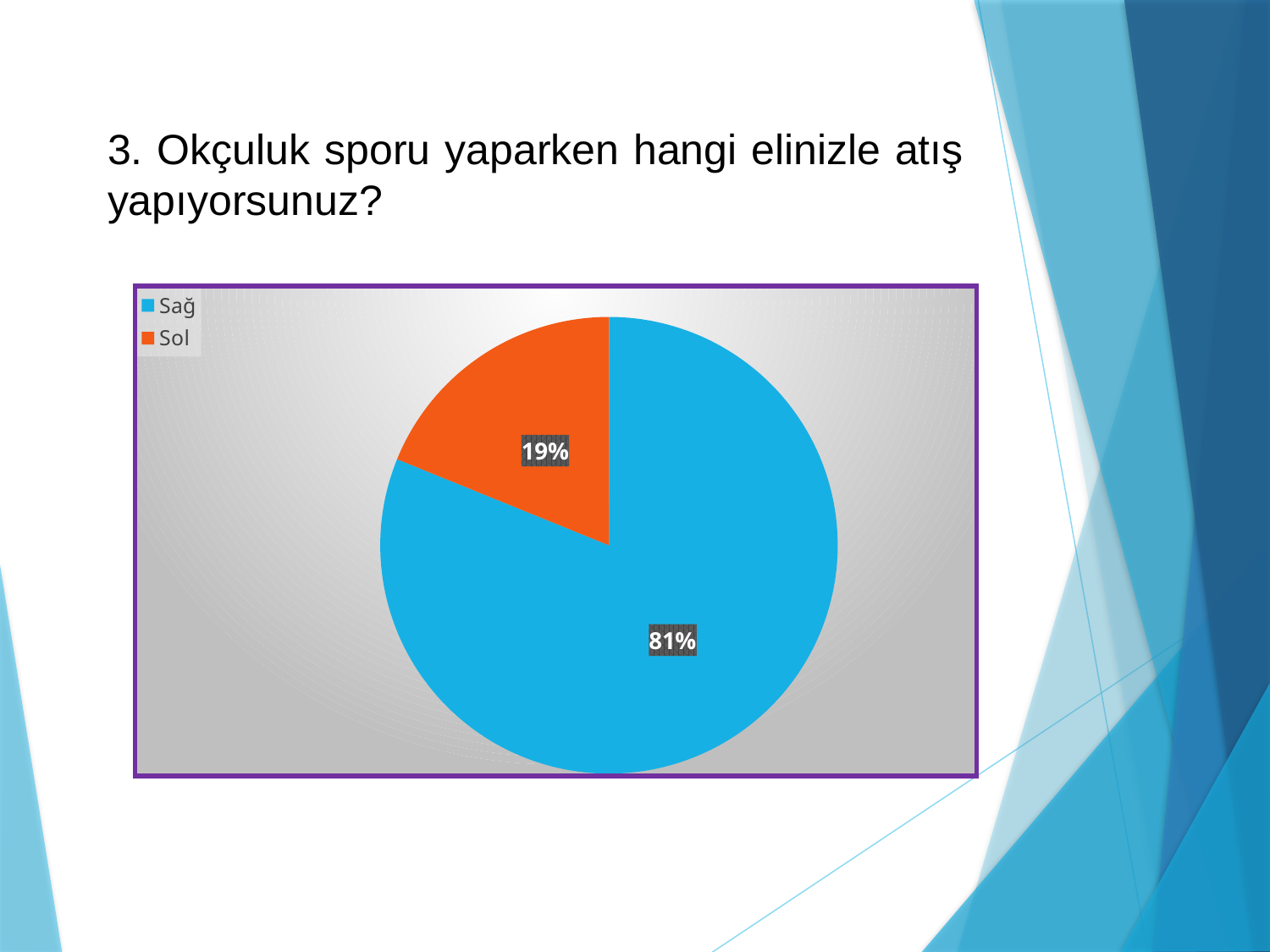
What colour is the Sağ slice? blue What share of the pie does Sağ represent? 81% Which slice is larger, Sağ or Sol? Sağ What is the difference in percentage points between the Sağ and Sol slices? 62 What share of the pie does Sol represent? 19% Which category has the smallest slice of the pie? Sol Which category has the largest slice of the pie? Sağ How many slices does the pie chart have? 2 How many entries does the legend list? 2 What colour is the Sol slice? orange What kind of chart is shown on the slide? pie chart